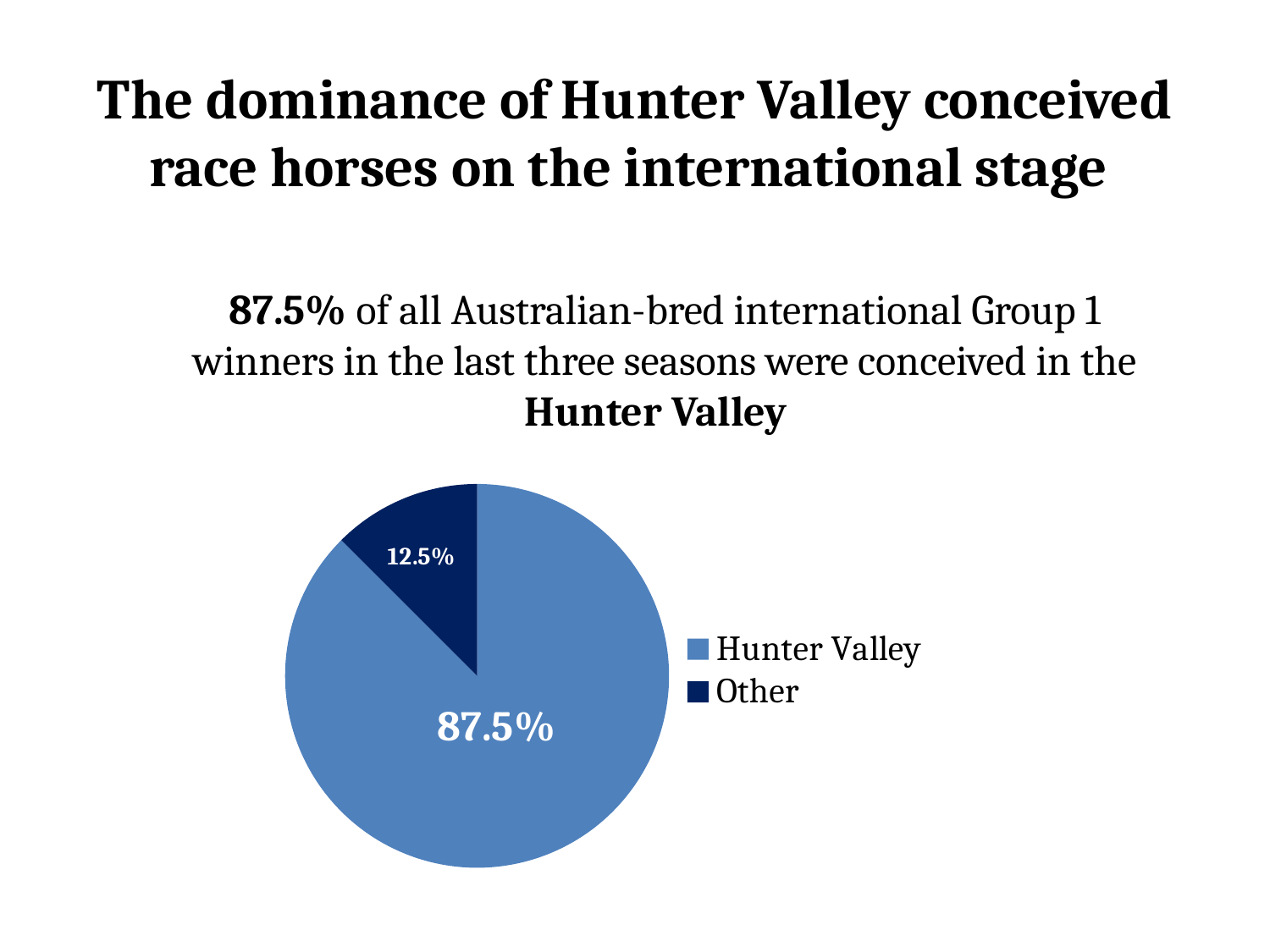
What is the difference between the Hunter Valley share and the Other share? 75% How many entries does the legend list? 2 Which slice of the pie is the largest? Hunter Valley What are the two legend entries of the pie chart? Hunter Valley and Other How many slices does the pie chart have? 2 What colour is the Other slice in the pie chart? dark navy blue What share of the pie does Hunter Valley represent? 87.5% What share of the pie does Other represent? 12.5% Which is larger, the Hunter Valley slice or the Other slice? Hunter Valley Which slice of the pie is the smallest? Other What kind of chart is shown on the slide? pie chart